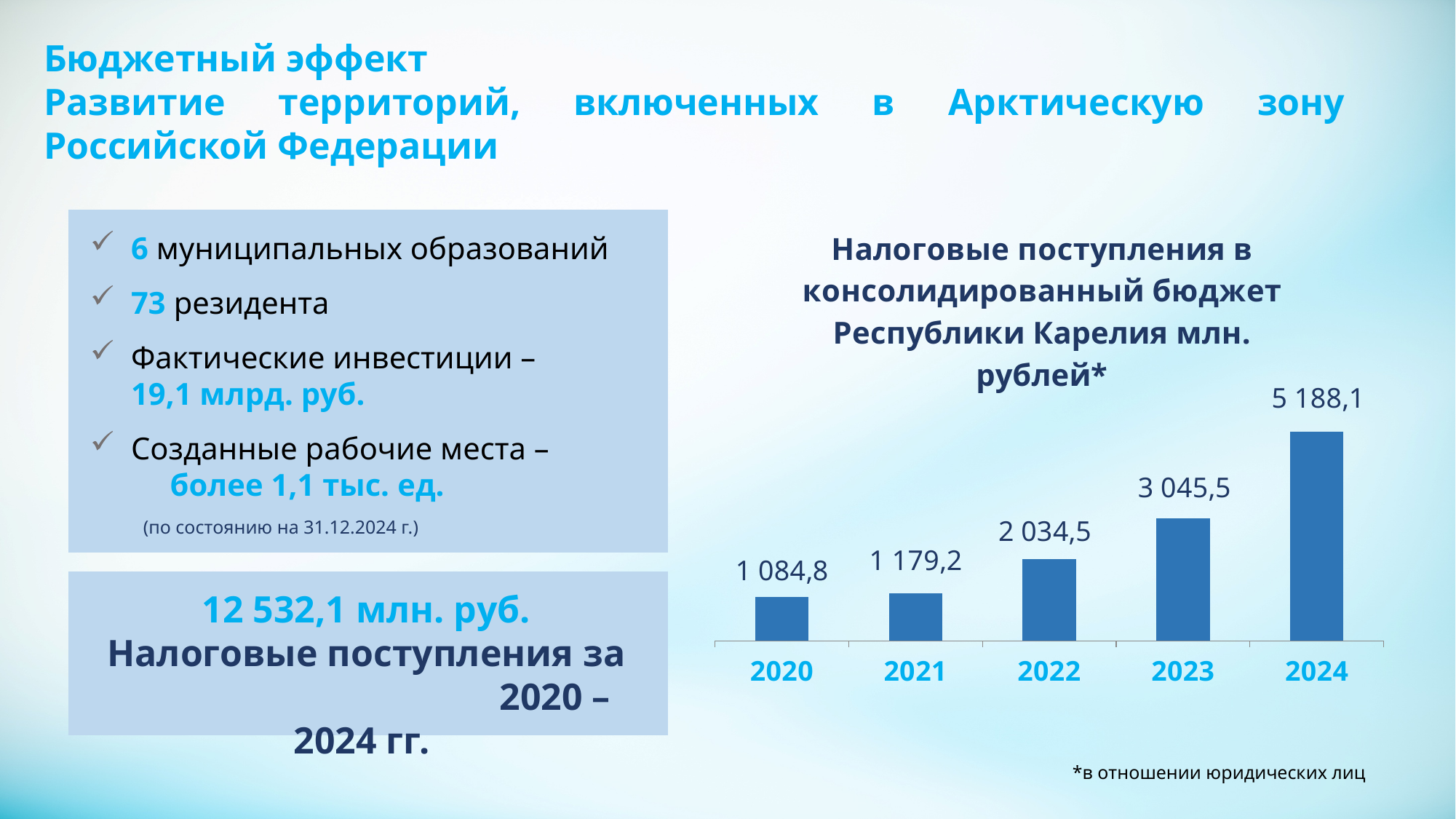
Which year has the highest value in the chart of tax revenues to the consolidated budget of the Republic of Karelia? 2024 Which is larger in the chart of tax revenues to the consolidated budget of the Republic of Karelia: the value for 2023 or the value for 2022? 2023 What is the difference between the 2022 and 2021 values in the chart of tax revenues to the consolidated budget of the Republic of Karelia? 855,3 What is the value for 2020 in the chart of tax revenues to the consolidated budget of the Republic of Karelia? 1 084,8 What is the value for 2024 in the chart of tax revenues to the consolidated budget of the Republic of Karelia? 5 188,1 Do the values in the chart of tax revenues to the consolidated budget of the Republic of Karelia rise or fall from 2020 to 2024? Rise What kind of chart is used to show tax revenues to the consolidated budget of the Republic of Karelia? Bar chart How many years are shown in the chart of tax revenues to the consolidated budget of the Republic of Karelia? 5 What is the difference between the 2024 and 2023 values in the chart of tax revenues to the consolidated budget of the Republic of Karelia? 2 142,6 Which year has the lowest value in the chart of tax revenues to the consolidated budget of the Republic of Karelia? 2020 What is the value for 2021 in the chart of tax revenues to the consolidated budget of the Republic of Karelia? 1 179,2 What is the value for 2022 in the chart of tax revenues to the consolidated budget of the Republic of Karelia? 2 034,5